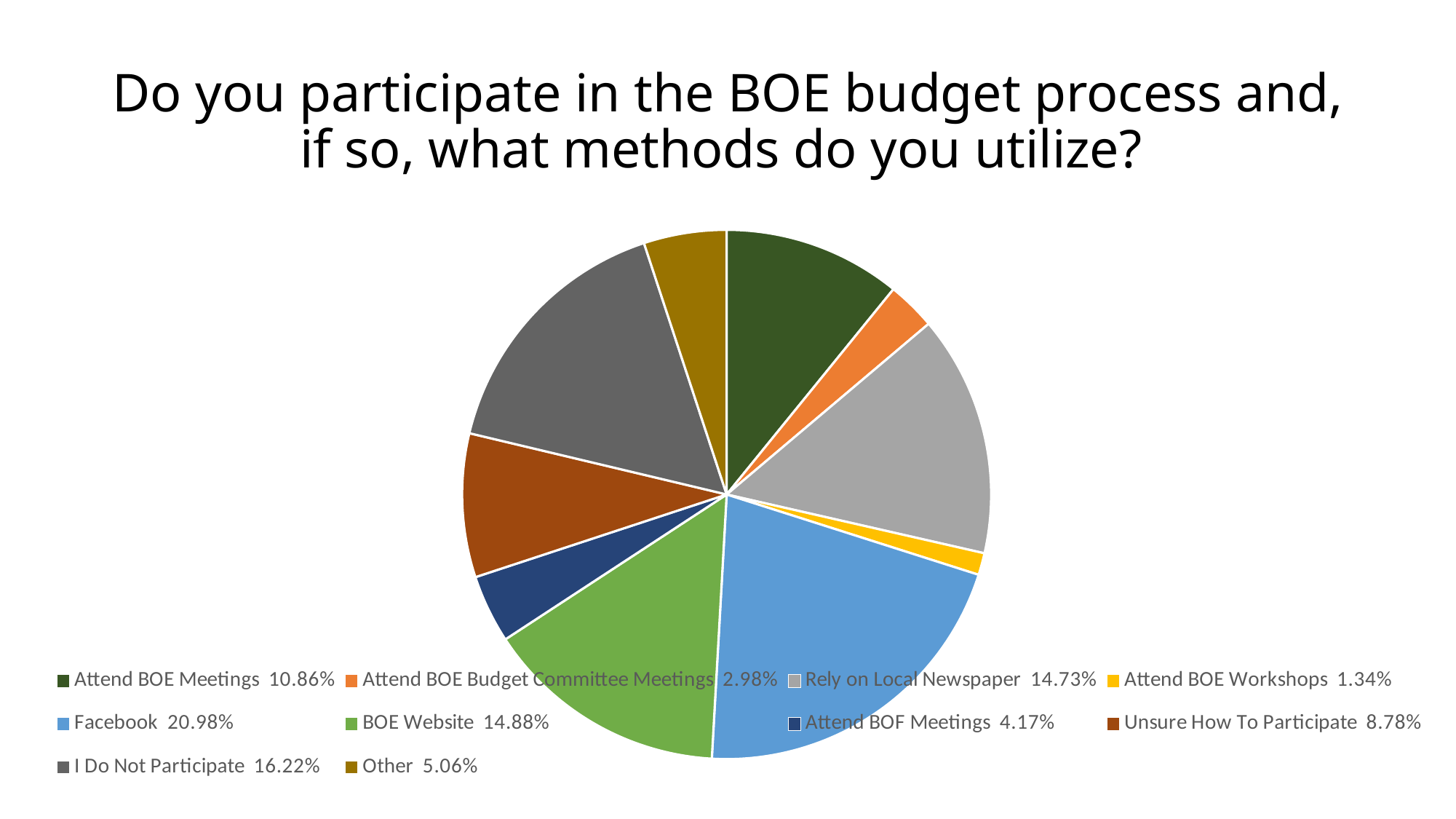
What is the title of the chart? Do you participate in the BOE budget process and, if so, what methods do you utilize? Which category has the largest share of the pie? Facebook What kind of chart is shown on the slide? pie chart How many categories does the pie chart show? 10 What percentage of respondents chose Facebook? 20.98% Which category has the smallest share of the pie? Attend BOE Workshops What percentage of respondents attend BOF Meetings? 4.17% What share of the pie does the Other slice represent? 5.06% Which is larger, the share for Attend BOE Meetings or the share for Unsure How To Participate? Attend BOE Meetings What is the difference between the Facebook share and the I Do Not Participate share? 4.76% What percentage of respondents said they do not participate? 16.22% What percentage of respondents rely on the local newspaper? 14.73%